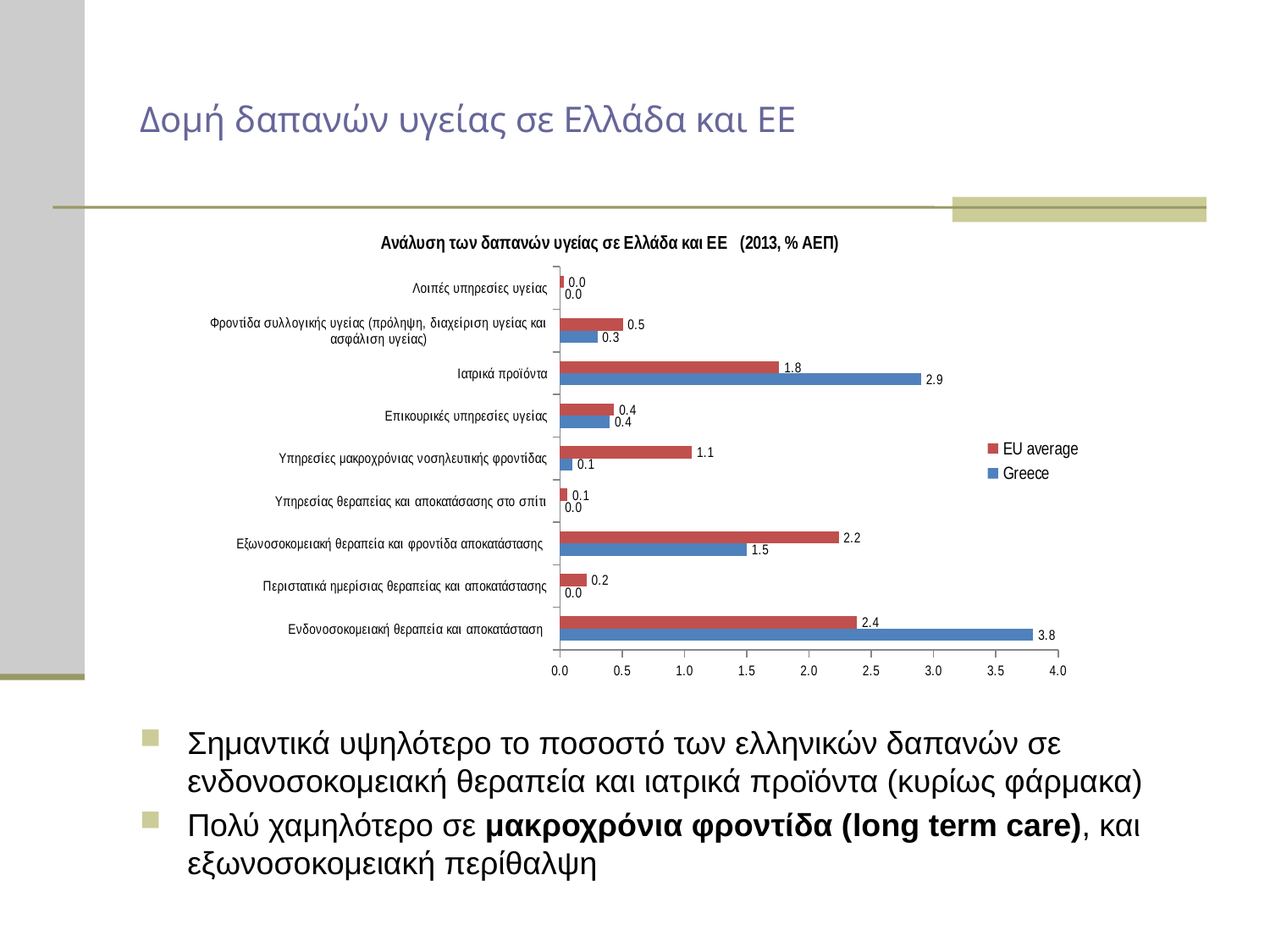
What is the difference between the EU average and Greece values for Υπηρεσίες μακροχρόνιας νοσηλευτικής φροντίδας? 1.0 Which category has the highest Greece value? Ενδονοσοκομειακή θεραπεία και αποκατάσταση For Ιατρικά προϊόντα, which is larger: the EU average or Greece? Greece What is the Greece value for Ιατρικά προϊόντα? 2.9 Which category has the highest EU average value? Ενδονοσοκομειακή θεραπεία και αποκατάσταση How many categories are shown on the chart? 9 What is the difference between the Greece and EU average values for Ενδονοσοκομειακή θεραπεία και αποκατάσταση? 1.4 What is the Greece value for Υπηρεσίες μακροχρόνιας νοσηλευτικής φροντίδας? 0.1 How many series does the legend list? 2 For Εξωνοσοκομειακή θεραπεία και φροντίδα αποκατάστασης, which is larger: the EU average or Greece? EU average What type of chart is shown on the slide? Bar chart What is the EU average value for Εξωνοσοκομειακή θεραπεία και φροντίδα αποκατάστασης? 2.2